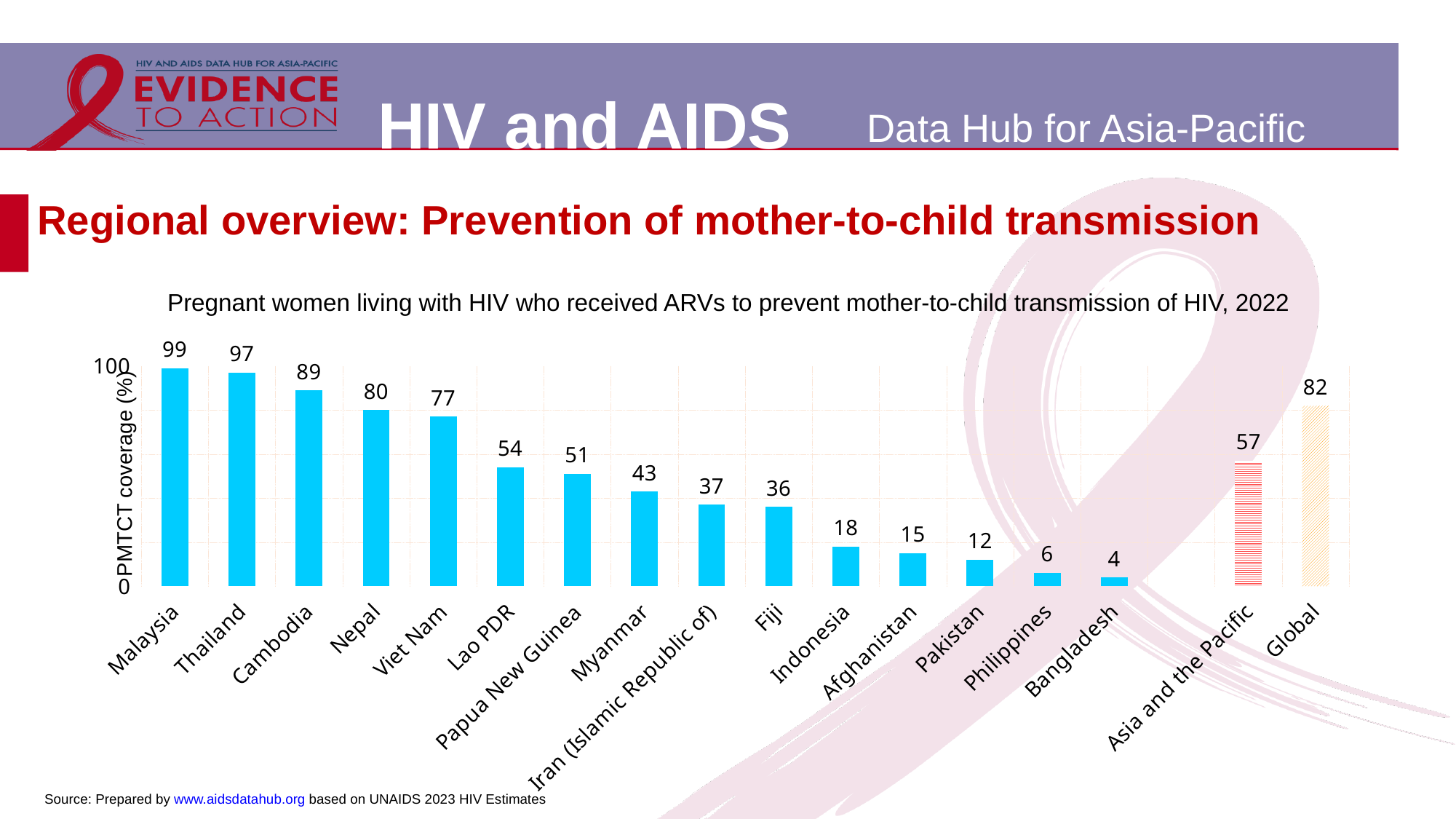
What kind of chart is shown on the slide? Bar chart What is the difference between the Global value and the Asia and the Pacific value? 25 Which country has the highest PMTCT coverage? Malaysia What is the value shown for Asia and the Pacific? 57 What is the difference between the values for Thailand and Cambodia? 8 How many categories (bars) are shown on the chart? 17 What is the PMTCT coverage value for Papua New Guinea? 51 What is the value shown for Global? 82 What is the PMTCT coverage value for Malaysia? 99 What is the title of the chart? Pregnant women living with HIV who received ARVs to prevent mother-to-child transmission of HIV, 2022 Which country has the lowest PMTCT coverage? Bangladesh Which has a higher PMTCT coverage, Nepal or Viet Nam? Nepal